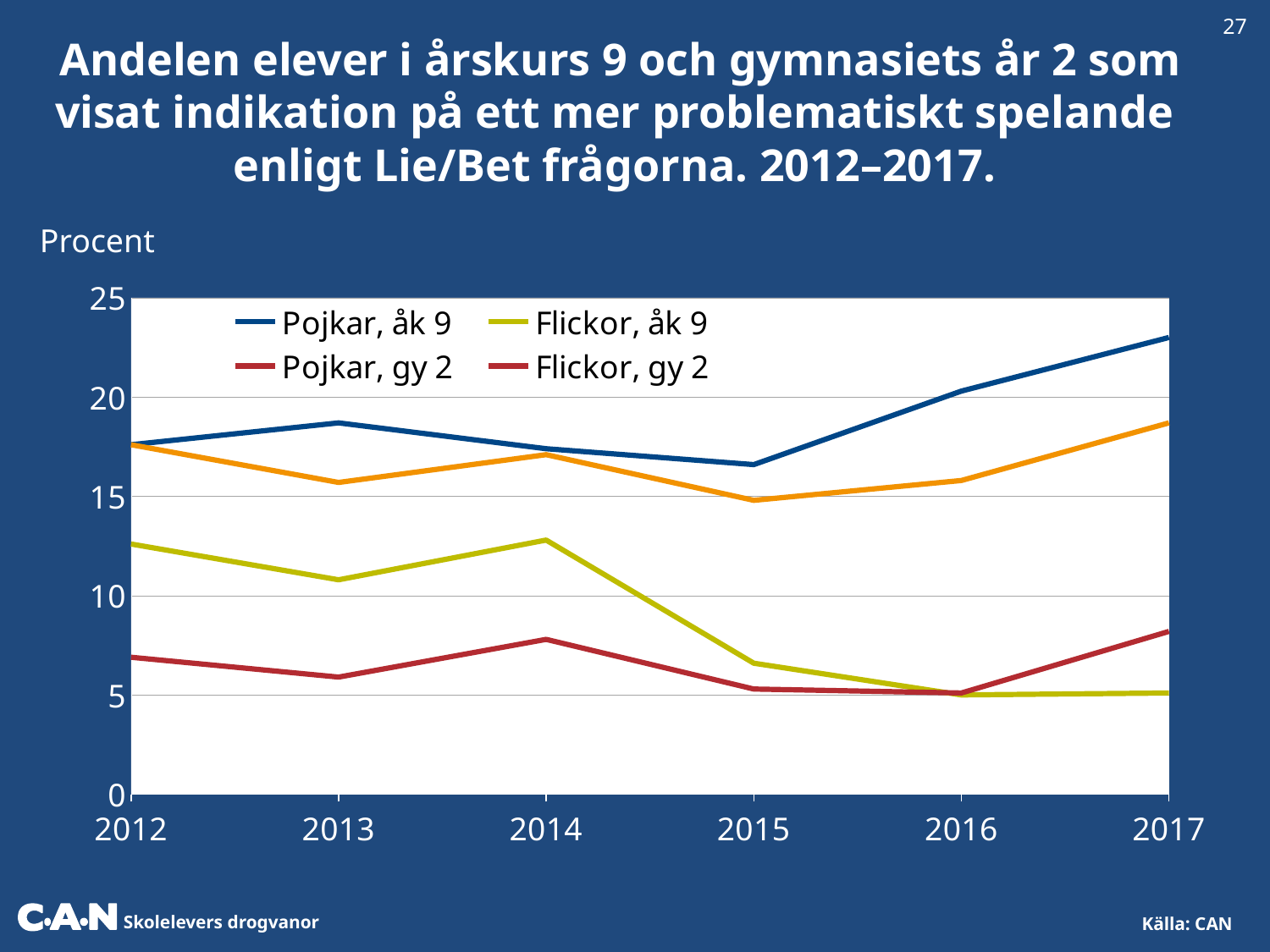
What label is shown above the y axis of the chart? Procent How many series does the legend list? 4 Which series has the highest value in 2017? Pojkar, åk 9 In which year is the value for Pojkar, åk 9 highest? 2017 Is the value for Flickor, åk 9 in 2012 greater or less than 10? greater Is the value for Pojkar, åk 9 in 2015 greater or less than 20? less Does the value for Flickor, åk 9 rise or fall from 2014 to 2016? fall Is the value for Flickor, åk 9 in 2016 greater or less than 10? less What kind of chart is shown on the slide? line chart How many years are shown on the x axis? 6 In 2014, which is larger: Pojkar, åk 9 or Flickor, åk 9? Pojkar, åk 9